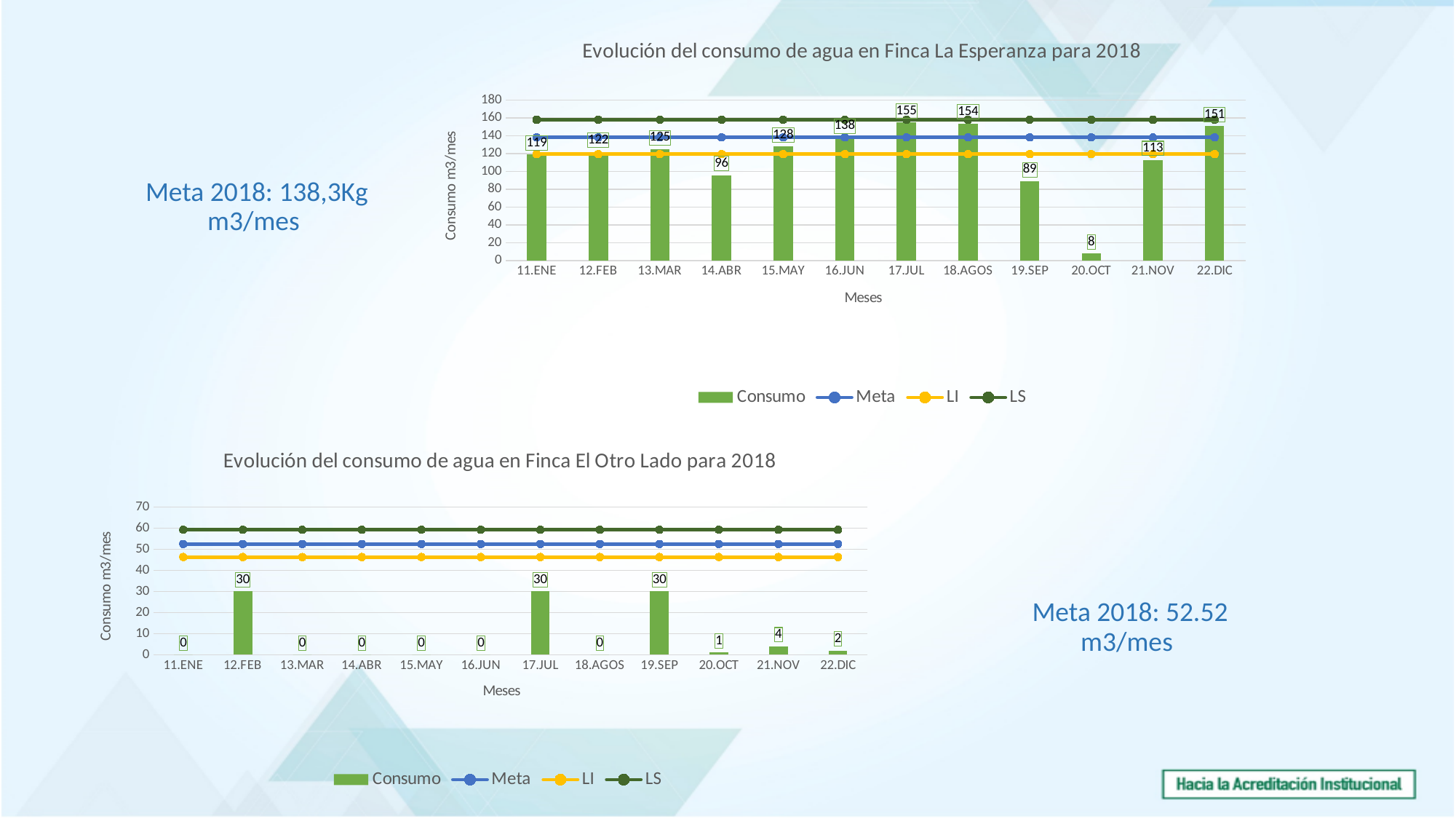
In the chart 'Evolución del consumo de agua en Finca El Otro Lado para 2018', which is larger, the Consumo value for 12.FEB or for 22.DIC? 12.FEB In the chart 'Evolución del consumo de agua en Finca La Esperanza para 2018', which month has the lowest Consumo value? 20.OCT In the chart 'Evolución del consumo de agua en Finca La Esperanza para 2018', what is the Consumo value for 20.OCT? 8 In the chart 'Evolución del consumo de agua en Finca La Esperanza para 2018', what is the difference between the Consumo values for 22.DIC and 21.NOV? 38 What type of chart is 'Evolución del consumo de agua en Finca El Otro Lado para 2018'? Bar chart with line series In the chart 'Evolución del consumo de agua en Finca La Esperanza para 2018', which month has the highest Consumo value? 17.JUL In the chart 'Evolución del consumo de agua en Finca El Otro Lado para 2018', what is the Consumo value for 21.NOV? 4 In the chart 'Evolución del consumo de agua en Finca La Esperanza para 2018', what is the Consumo value for 17.JUL? 155 In the chart 'Evolución del consumo de agua en Finca El Otro Lado para 2018', is the LS line greater or less than 50? greater How many series does the legend of the chart 'Evolución del consumo de agua en Finca La Esperanza para 2018' list? 4 In the chart 'Evolución del consumo de agua en Finca El Otro Lado para 2018', how many months are shown on the x axis? 12 In the chart 'Evolución del consumo de agua en Finca La Esperanza para 2018', is the Consumo value for 14.ABR greater or less than 100? less